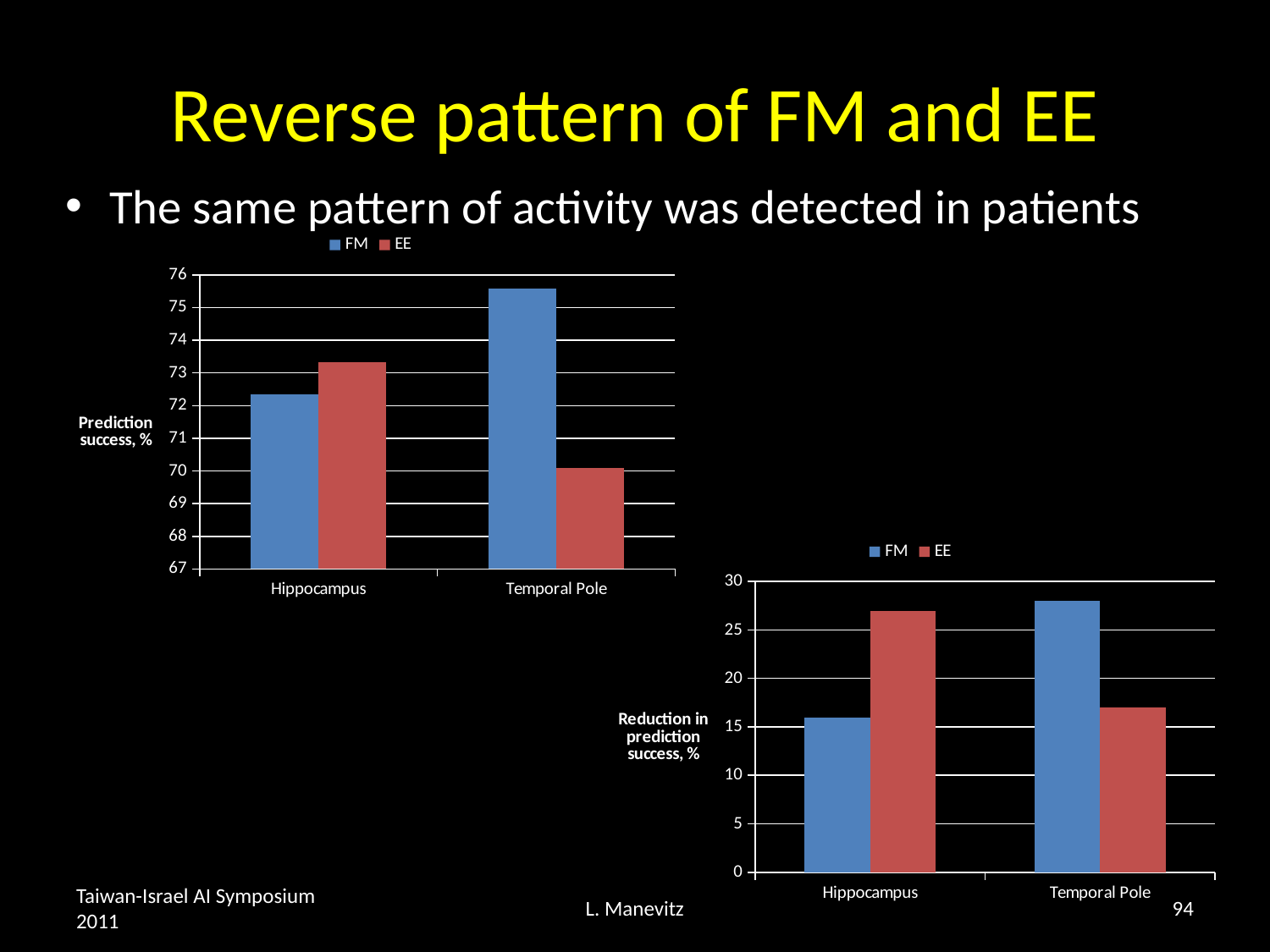
In the left chart (Prediction success, %), which bar is the lowest? EE for Temporal Pole How many series does the legend of the left chart (Prediction success, %) list? 2 How many categories are shown on the x axis of the right chart (Reduction in prediction success, %)? 2 In the left chart (Prediction success, %), which bar is the highest? FM for Temporal Pole In the right chart (Reduction in prediction success, %), which is larger for Temporal Pole, FM or EE? FM In the left chart (Prediction success, %), which is larger for Hippocampus, FM or EE? EE In the right chart (Reduction in prediction success, %), is the FM value for Hippocampus greater or less than 20? less In the right chart (Reduction in prediction success, %), is the EE value for Hippocampus greater or less than 25? greater In the left chart (Prediction success, %), is the FM value for Hippocampus greater or less than 73? less What is the y-axis label of the right chart on the slide? Reduction in prediction success, % What kind of chart is the chart on the left of the slide (Prediction success, %)? bar chart